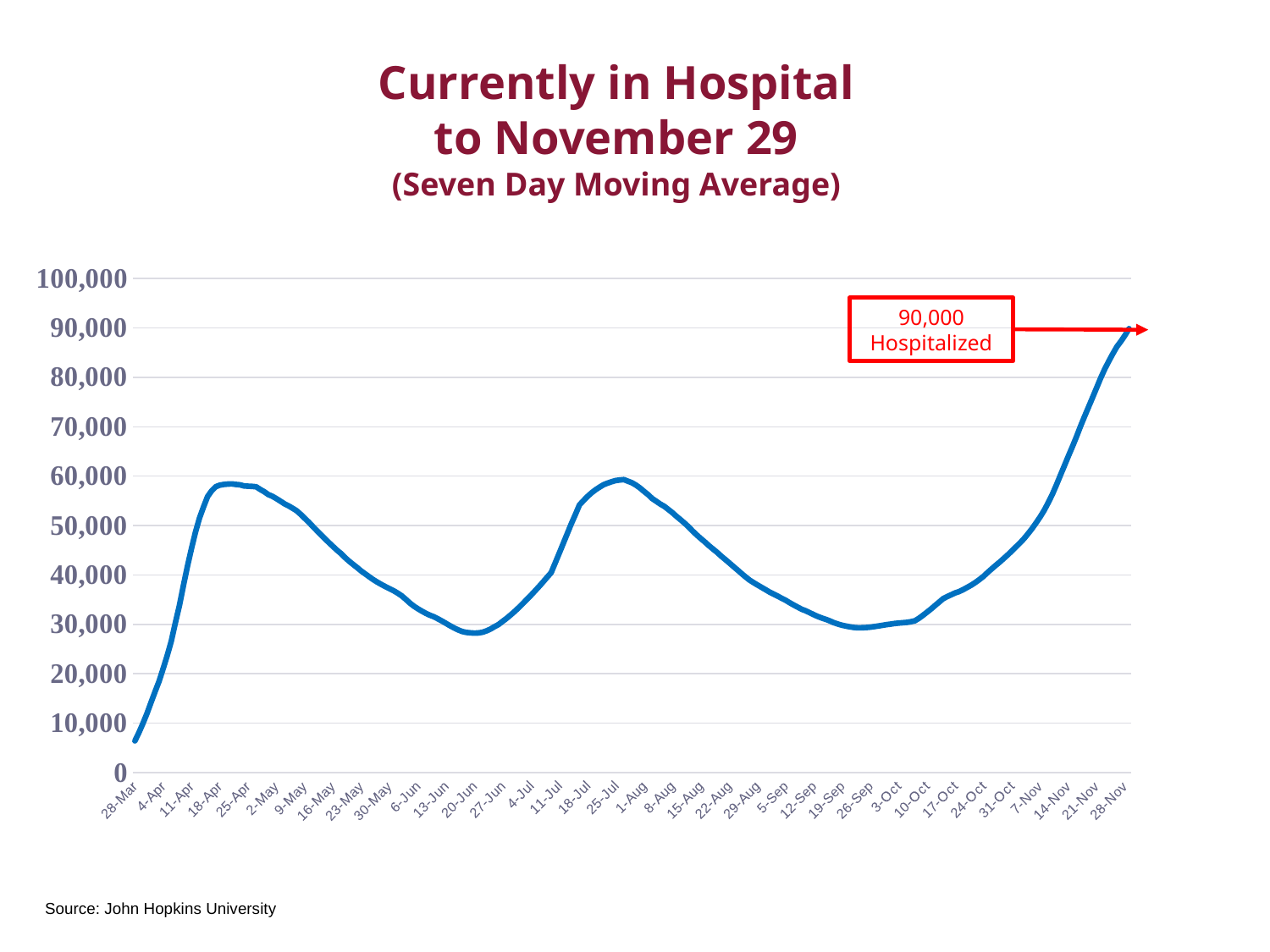
On which date does the line have its lowest value? 28-Mar Is the value for 26-Sep greater or less than 40,000? less On which date does the line reach its highest value? 28-Nov Is the value for 7-Nov greater or less than 60,000? less Is the value for 18-Apr greater or less than 50,000? greater Do the values rise or fall between 25-Jul and 26-Sep? fall According to the annotation, how many people were hospitalized at the end of the series (28-Nov)? 90,000 What kind of chart is shown on the slide? line chart What source is cited for the chart data? John Hopkins University Which date has the larger value, 20-Jun or 25-Jul? 25-Jul Which date has the larger value, 18-Apr or 28-Nov? 28-Nov